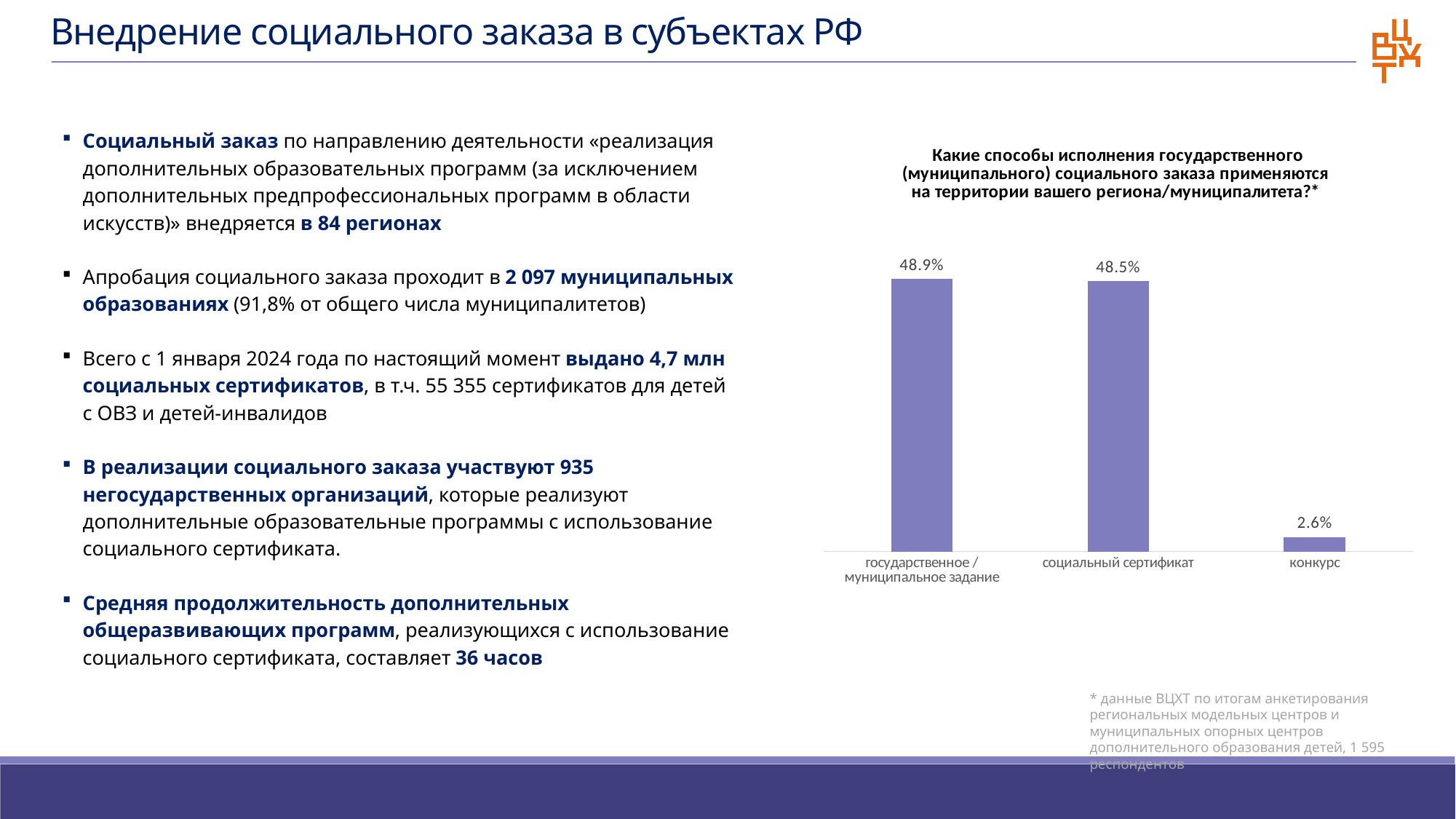
How many categories are shown in the chart? 3 What colour are the bars in the chart? purple Do the values rise or fall from left to right across the categories? fall Which is larger: the value for «социальный сертификат» or the value for «конкурс»? социальный сертификат What kind of chart is shown on the slide? bar chart What is the value for «социальный сертификат» in the chart? 48.5% What is the value for «конкурс» in the chart? 2.6% What is the value for «государственное / муниципальное задание» in the chart? 48.9% Which category has the lowest value in the chart? конкурс Which category has the highest value in the chart? государственное / муниципальное задание What is the difference between the values for «государственное / муниципальное задание» and «конкурс»? 46.3% What is the difference between the values for «социальный сертификат» and «конкурс»? 45.9%